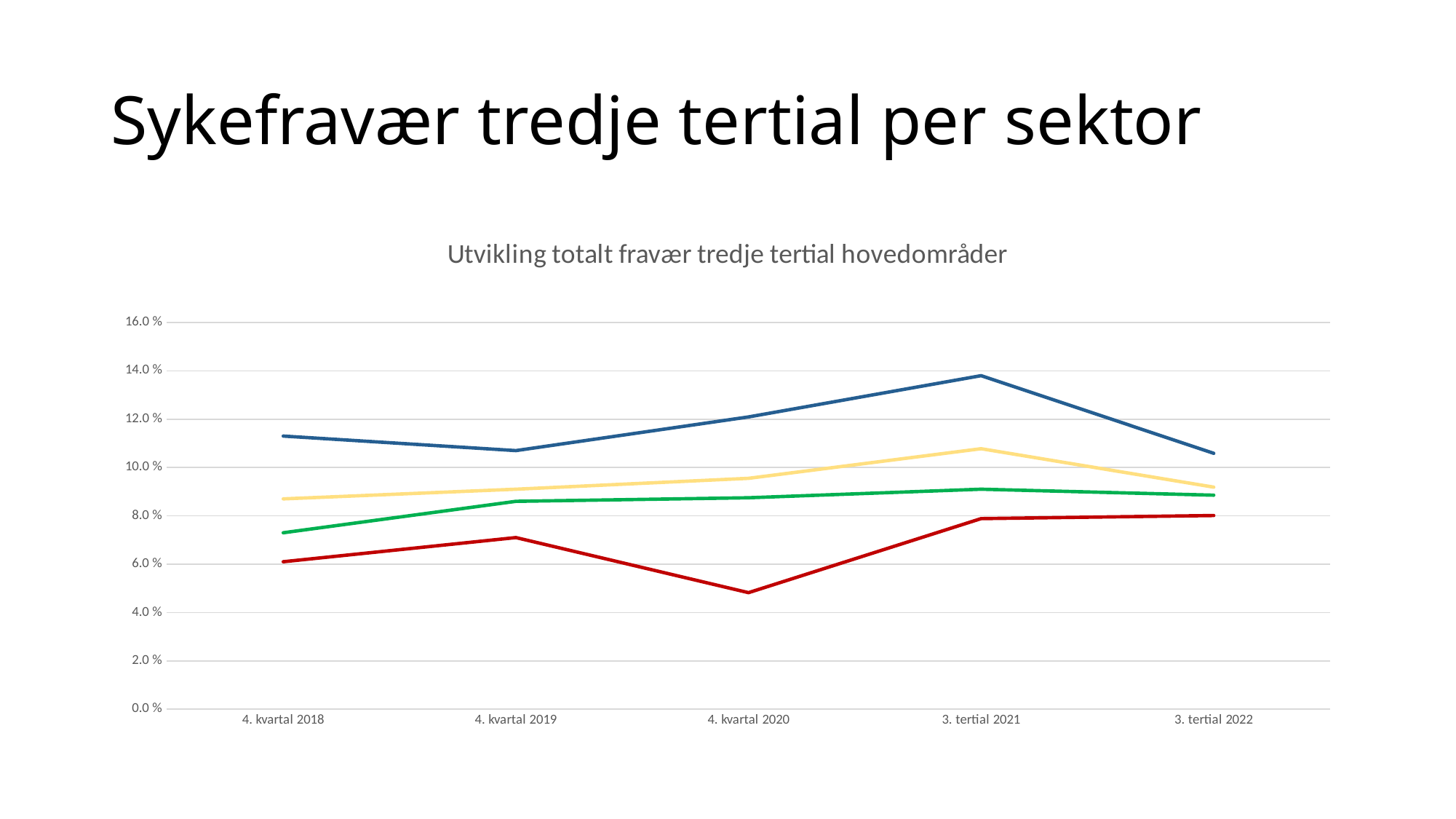
Is the value of the red line at 4. kvartal 2020 greater or less than 6.0 %? less What kind of chart is shown on the slide? line chart How many categories are shown along the x axis of the chart? 5 Is the value of the green line at 4. kvartal 2018 greater or less than 8.0 %? less Does the blue line rise or fall between 3. tertial 2021 and 3. tertial 2022? fall How many lines are plotted in the chart? 4 Which line has the highest value at 3. tertial 2021? the blue line Is the value of the yellow line at 3. tertial 2021 greater or less than 10.0 %? greater What is the title of the chart? Utvikling totalt fravær tredje tertial hovedområder Which line has the lowest value at 4. kvartal 2020? the red line At 4. kvartal 2019, which is larger: the value of the blue line or the value of the yellow line? the blue line